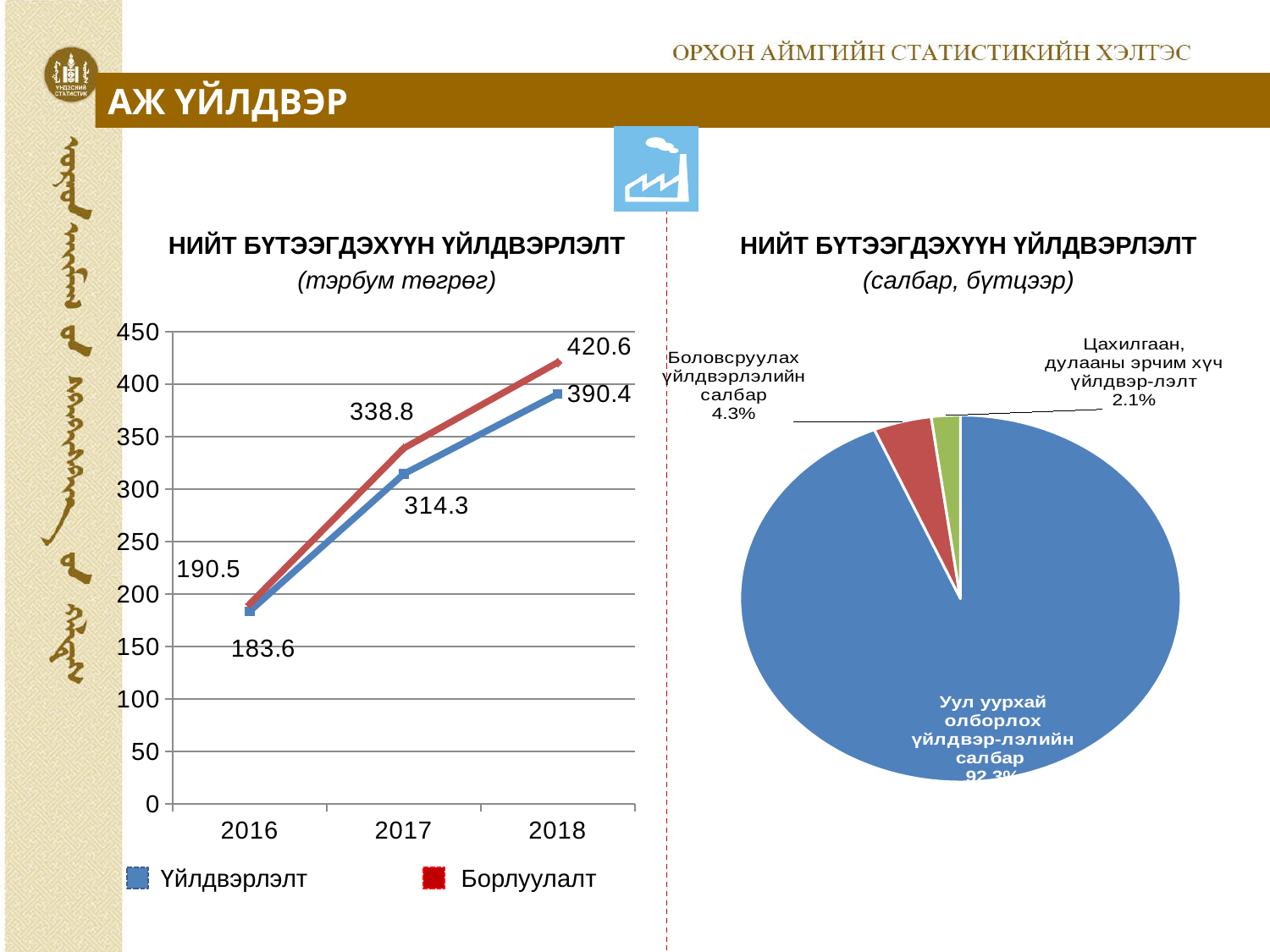
On the left chart (тэрбум төгрөг), do the values of Борлуулалт rise or fall from 2016 to 2018? rise On the left chart (тэрбум төгрөг), how many years are shown on the x axis? 3 On the left chart (тэрбум төгрөг), what is the value of Үйлдвэрлэлт in 2017? 314.3 On the left chart (тэрбум төгрөг), in which year is Үйлдвэрлэлт highest? 2018 On the right pie chart (салбар, бүтцээр), what share does Боловсруулах үйлдвэрлэлийн салбар have? 4.3% On the left chart (тэрбум төгрөг), what is the value of Үйлдвэрлэлт in 2016? 183.6 On the left chart (тэрбум төгрөг), what is the value of Борлуулалт in 2018? 420.6 On the left chart (тэрбум төгрөг), which series has the higher value in 2017, Үйлдвэрлэлт or Борлуулалт? Борлуулалт What kind of chart is the left chart (тэрбум төгрөг)? line chart On the right pie chart (салбар, бүтцээр), which sector has the smallest share? Цахилгаан, дулааны эрчим хүч үйлдвэрлэлт On the left chart (тэрбум төгрөг), what is the difference between Борлуулалт and Үйлдвэрлэлт in 2018? 30.2 On the left chart (тэрбум төгрөг), how many series does the legend list? 2